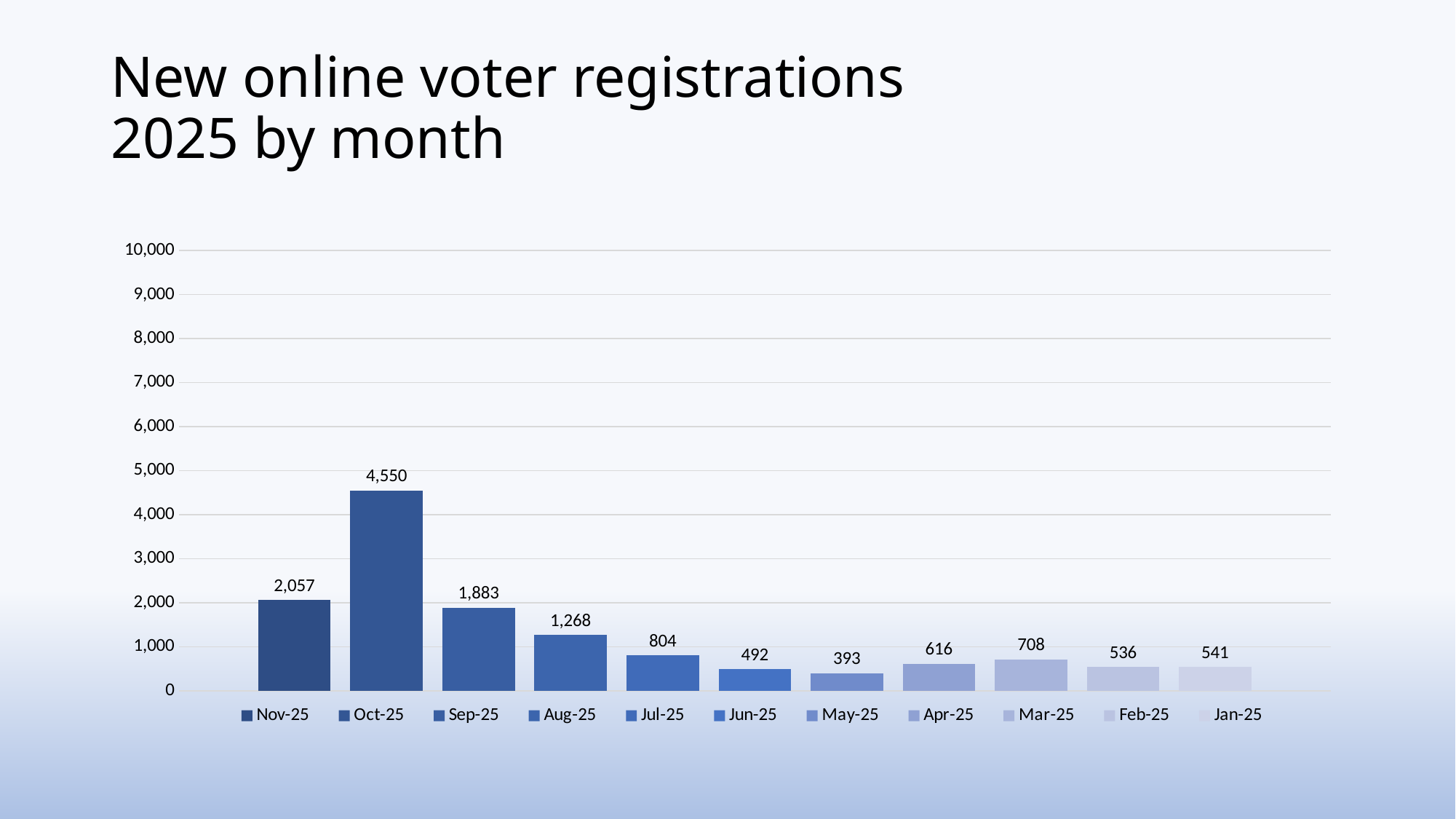
Which is larger, the value for Jul-25 or the value for Mar-25? Jul-25 Is the value for Nov-25 greater or less than 2,000? greater What is the difference between the values for Oct-25 and Nov-25? 2,493 What is the difference between the values for Sep-25 and Aug-25? 615 Which month has the lowest value? May-25 What kind of chart is shown on the slide? bar chart What is the value for Oct-25? 4,550 Which month has the highest value? Oct-25 What is the value for Mar-25? 708 How many months are shown in the chart? 11 What is the value for Aug-25? 1,268 What is the title of the slide? New online voter registrations 2025 by month